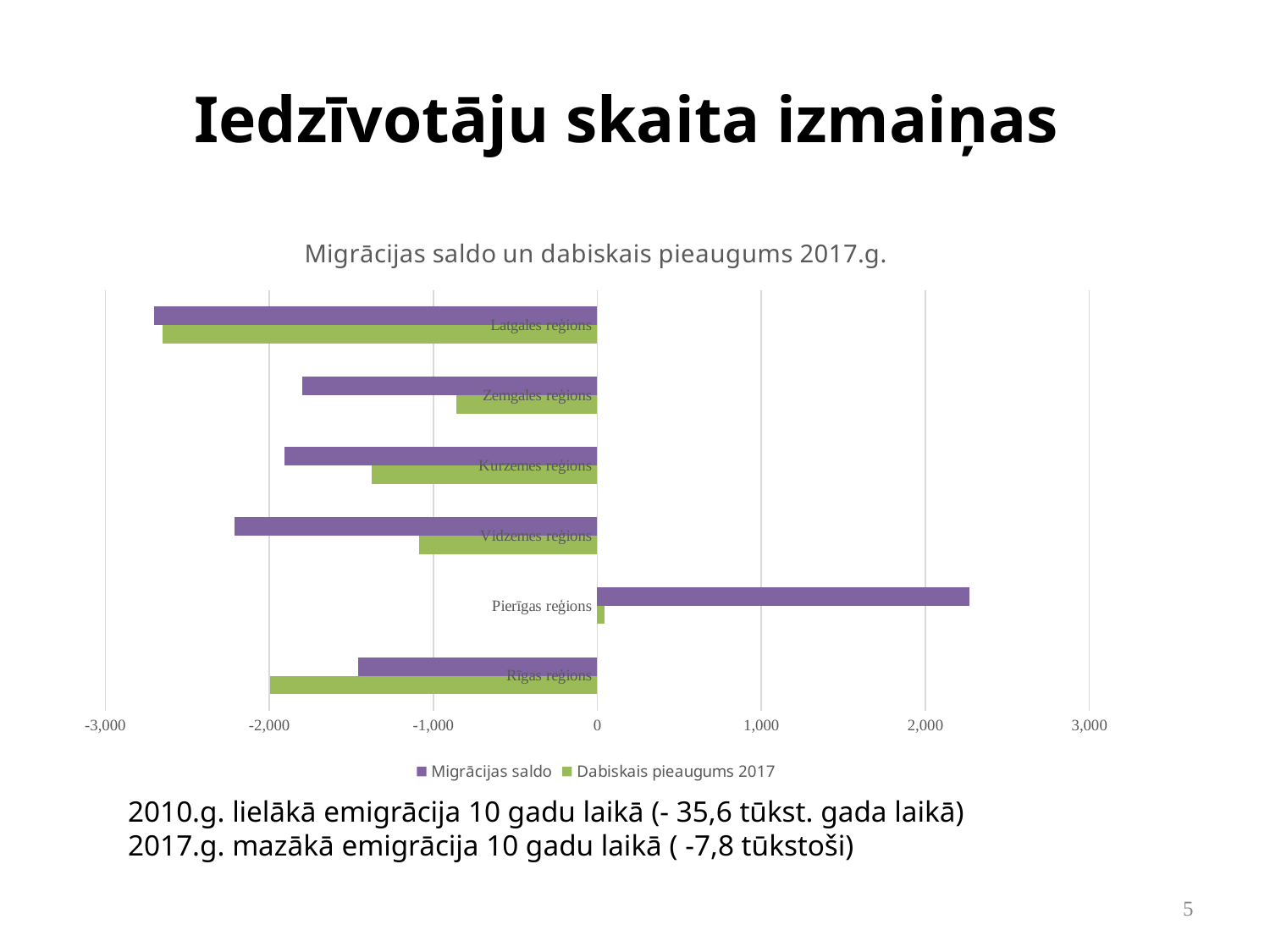
Which region has the lowest Migrācijas saldo value? Latgales reģions Is the Migrācijas saldo value for Pierīgas reģions greater or less than 2,000? greater How many series does the legend list? 2 How many regions are shown on the chart? 6 What is the title of the chart? Migrācijas saldo un dabiskais pieaugums 2017.g. Is the Migrācijas saldo value for Vidzemes reģions greater or less than -2,000? less What kind of chart is shown on the slide? bar chart Which region has the lowest Dabiskais pieaugums 2017 value? Latgales reģions For Rīgas reģions, which is larger: the Migrācijas saldo value or the Dabiskais pieaugums 2017 value? Migrācijas saldo Is the Dabiskais pieaugums 2017 value for Zemgales reģions greater or less than -1,000? greater Which series is shown in green? Dabiskais pieaugums 2017 Which region has the highest Migrācijas saldo value? Pierīgas reģions